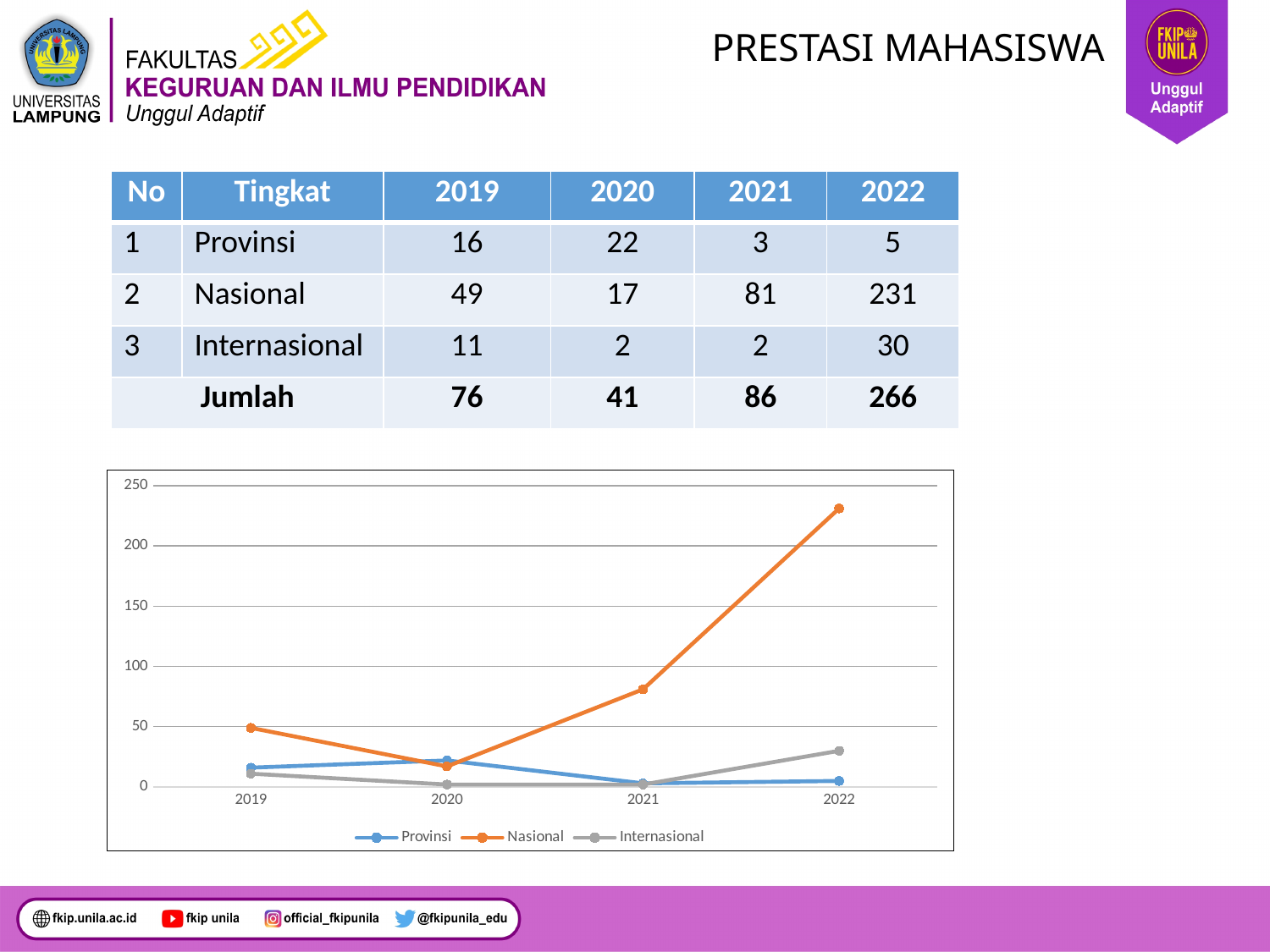
In 2019, which is larger: the value for Nasional or the value for Provinsi? Nasional Does the Nasional series rise or fall from 2020 to 2022? rise According to the table on the slide, what is the Nasional value for 2022? 231 Which series has the highest value in 2022? Nasional Which series has the lowest value in 2020? Internasional Is the value for Provinsi in 2019 greater or less than 50? less What kind of chart is shown on the slide? line chart Is the value for Nasional in 2021 greater or less than 100? less How many series does the chart legend list? 3 According to the table on the slide, what is the difference between the Nasional values for 2022 and 2021? 150 Is the value for Nasional in 2022 greater or less than 200? greater How many years are plotted along the x axis of the chart? 4